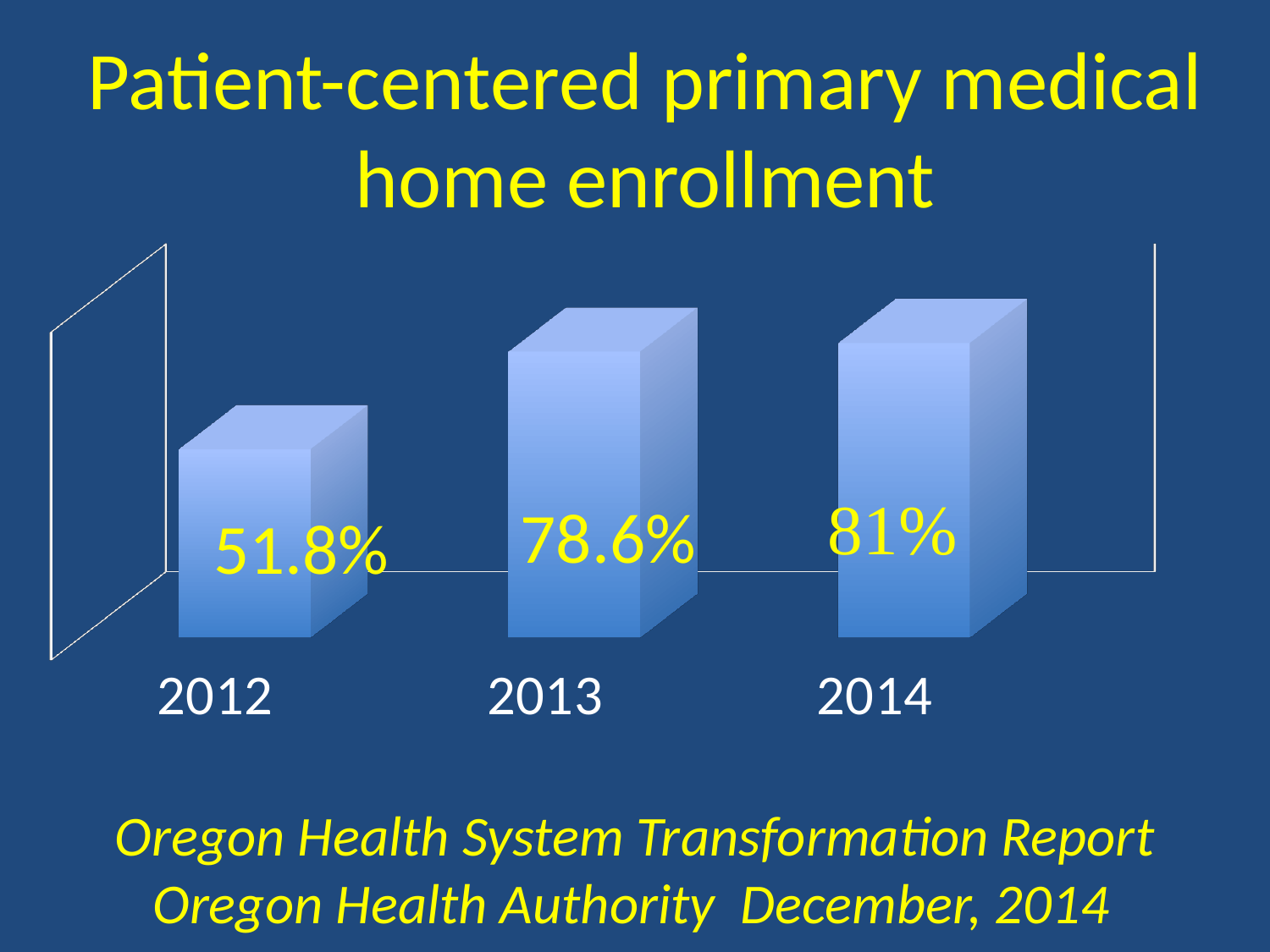
What is the difference in enrollment between 2013 and 2012? 26.8 percentage points What is the difference in enrollment between 2014 and 2013? 2.4 percentage points What is the enrollment value shown for 2013? 78.6% What is the title of the slide containing the chart? Patient-centered primary medical home enrollment Which year has the larger enrollment value, 2012 or 2013? 2013 Which year has the highest enrollment value? 2014 What is the enrollment value shown for 2014? 81% What kind of chart is shown on the slide? Bar chart What is the patient-centered primary medical home enrollment value for 2012? 51.8% How many years are shown on the chart? 3 Do the enrollment values rise or fall from 2012 to 2014? Rise Which year has the lowest enrollment value? 2012